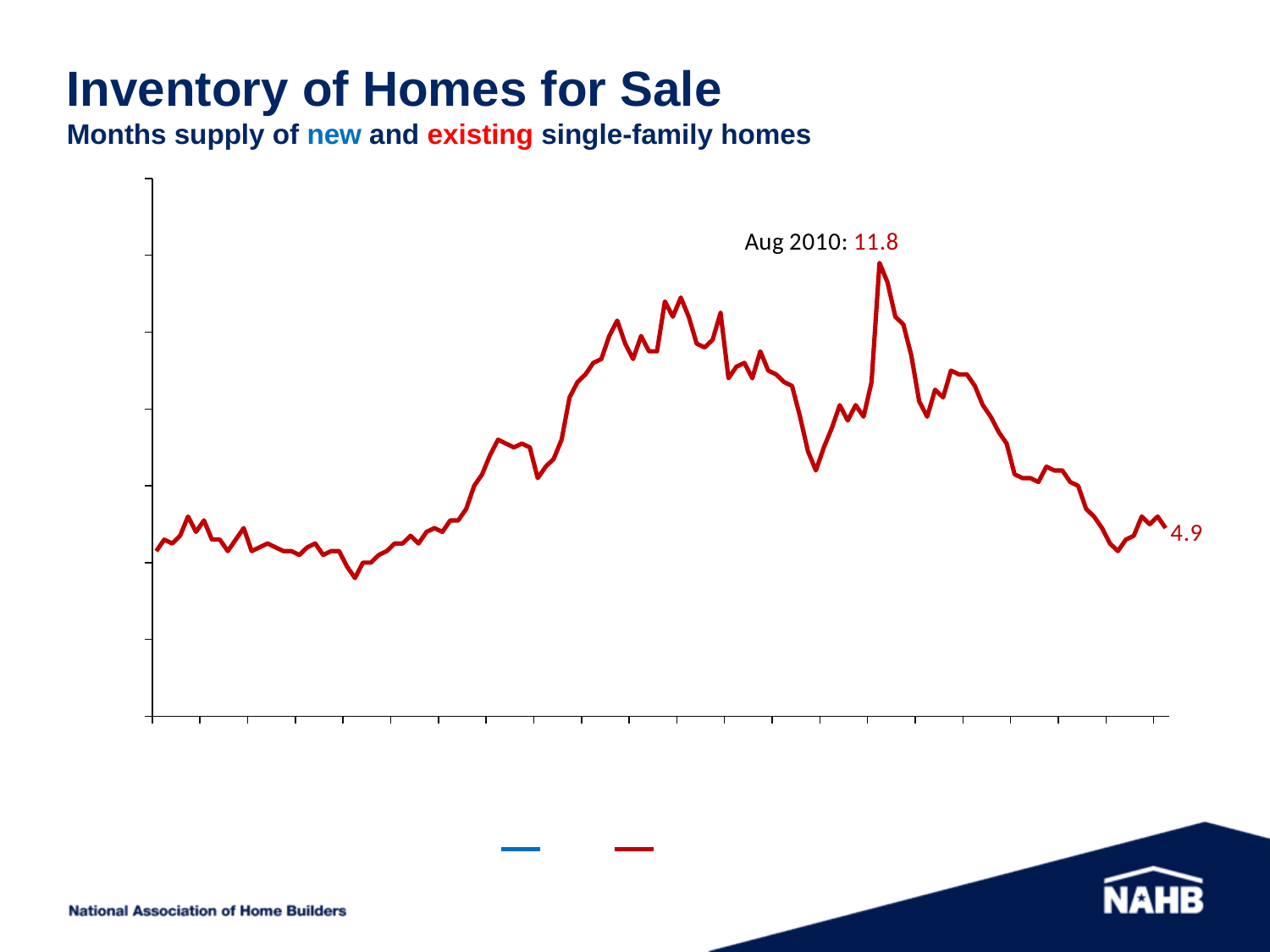
What kind of chart is shown on the slide? line chart Which month is labelled as the peak of the red line? Aug 2010 What colour is the line plotted on the chart? red How many series does the legend below the chart show? 2 What is the difference between the Aug 2010 value and the latest labelled value of 4.9? 6.9 What value is labelled for Aug 2010 on the chart? 11.8 Does the red line rise or fall from its Aug 2010 peak to the right-hand end of the chart? fall What is the title of the chart on the slide? Inventory of Homes for Sale Which is larger, the Aug 2010 value or the latest labelled value? Aug 2010 What is the value labelled at the right-hand end of the red line? 4.9